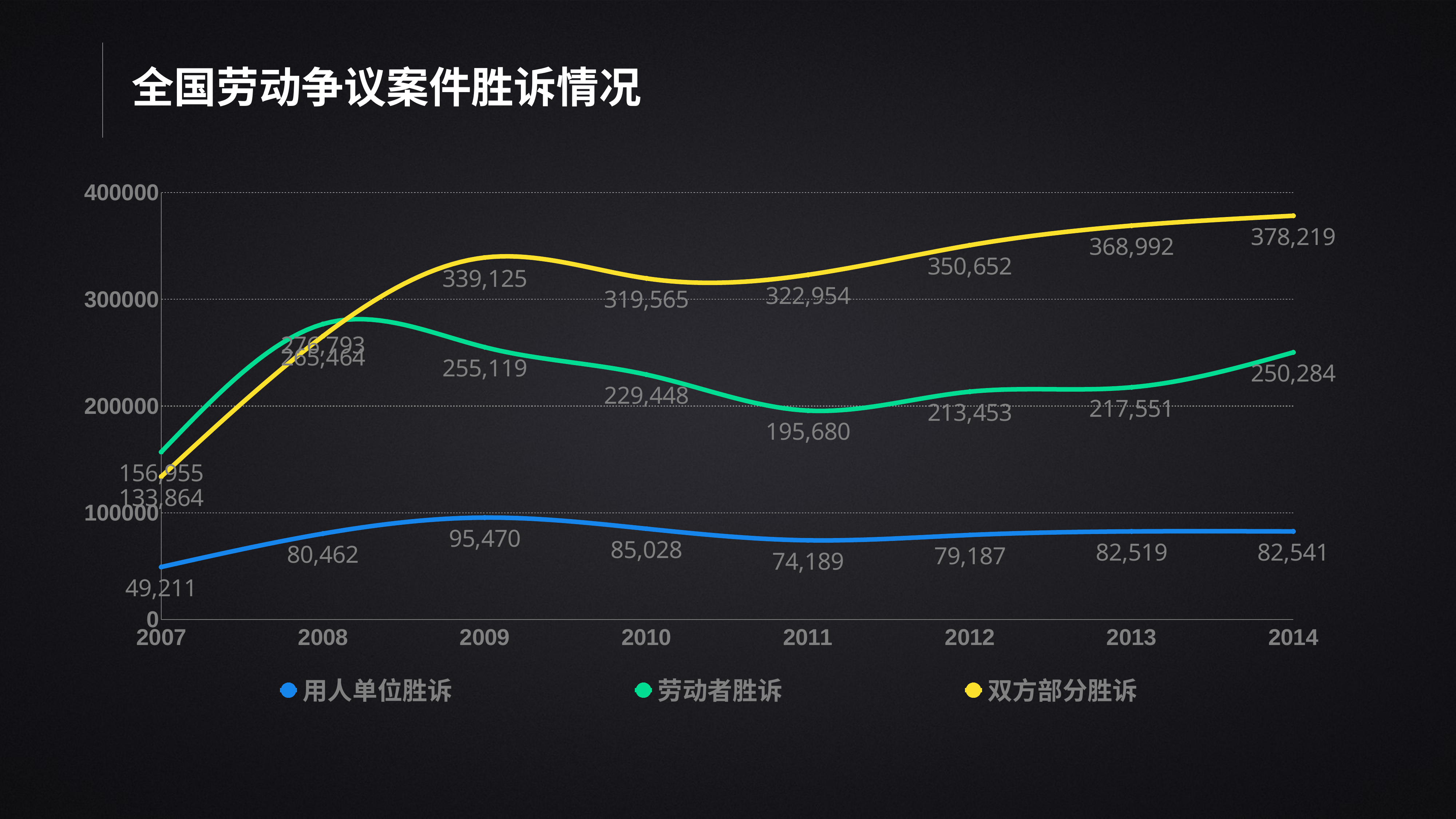
In 2012, which is larger: 劳动者胜诉 or 双方部分胜诉? 双方部分胜诉 What is the value for 双方部分胜诉 in 2014? 378,219 What is the value for 用人单位胜诉 in 2009? 95,470 How many years are plotted along the x axis? 8 What kind of chart is shown on the slide? Line chart How many series does the legend list? 3 Does 用人单位胜诉 rise or fall from 2007 to 2009? Rise In which year is 劳动者胜诉 lowest? 2007 Is the value for 双方部分胜诉 in 2009 greater or less than 300000? greater What is the difference between the 双方部分胜诉 values for 2014 and 2013? 9,227 In which year is 用人单位胜诉 highest? 2009 What is the value for 劳动者胜诉 in 2011? 195,680